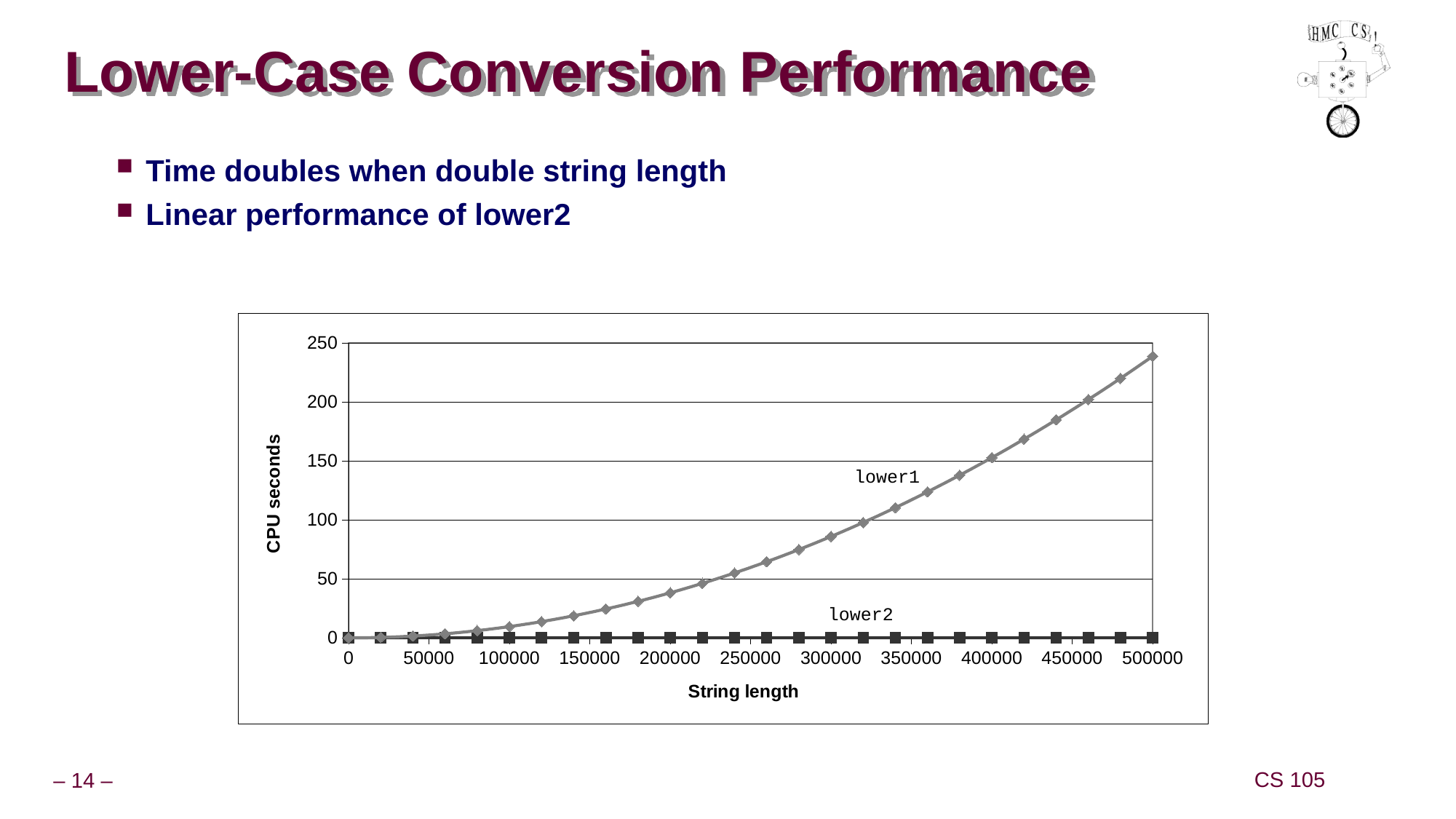
Do the values for lower1 rise or fall as string length increases? rise What are the names of the two series plotted on the chart? lower1 and lower2 Is the value for lower1 at a string length of 500000 greater or less than 200? greater Which series reaches the highest CPU seconds value on the chart? lower1 Is the value for lower1 at a string length of 300000 greater or less than 100? less Is the value for lower1 at a string length of 200000 greater or less than 50? less How many series are plotted on the chart? 2 What is the label of the y axis? CPU seconds What kind of chart is shown on the slide? line chart What is the largest string length shown on the x axis? 500000 Which series has the larger value at a string length of 400000, lower1 or lower2? lower1